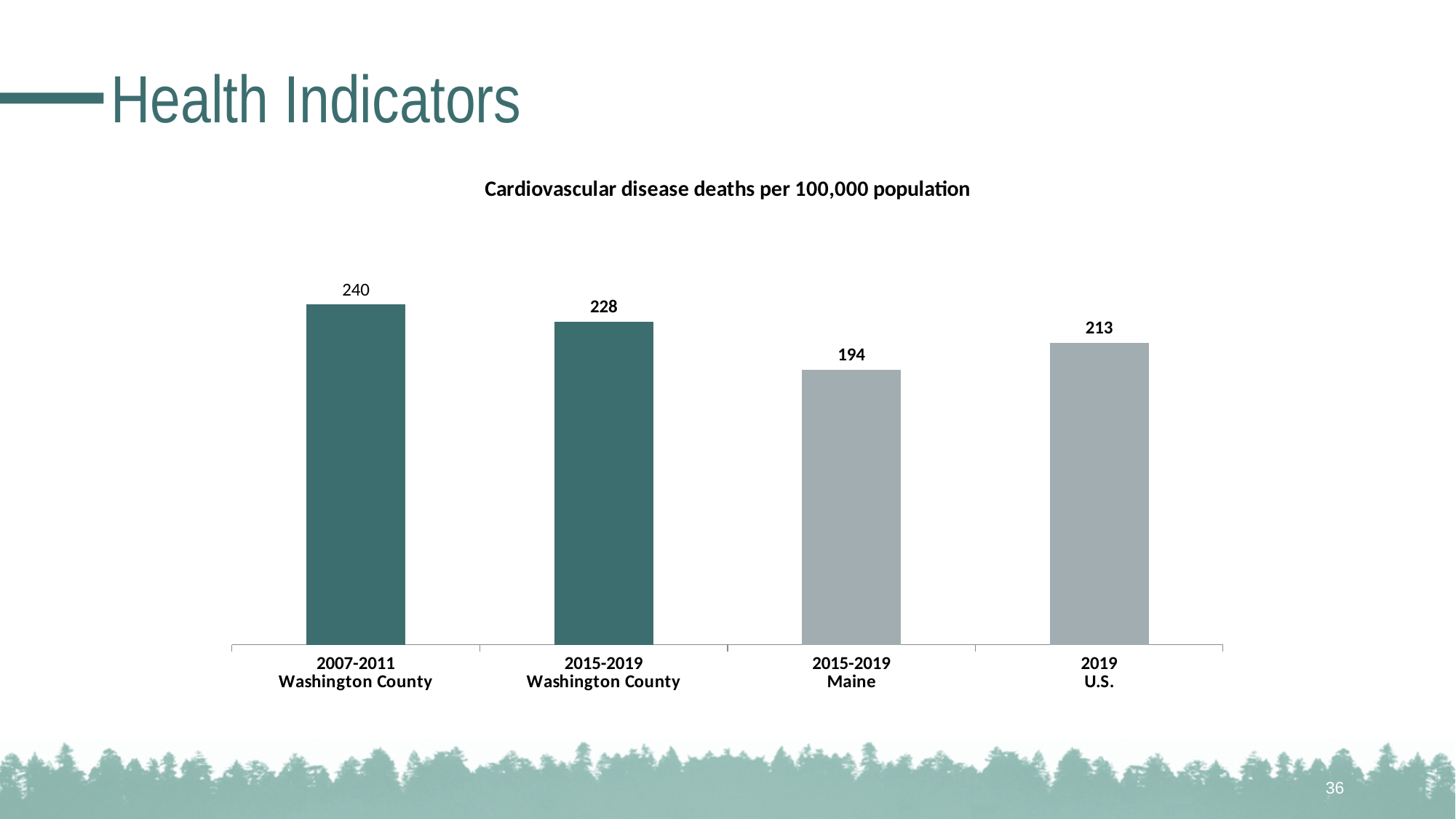
What is the value for 2019 U.S.? 213 Which category has the highest value? 2007-2011 Washington County What is the value for 2015-2019 Washington County? 228 What kind of chart is shown on the slide? Bar chart Which category has the lowest value? 2015-2019 Maine What is the difference between the 2019 U.S. value and the 2015-2019 Maine value? 19 How many bars are shown in the chart? 4 What is the title of the chart? Cardiovascular disease deaths per 100,000 population Which is larger, the value for 2015-2019 Washington County or the value for 2019 U.S.? 2015-2019 Washington County What is the difference between the 2007-2011 Washington County value and the 2015-2019 Washington County value? 12 What is the value for 2007-2011 Washington County? 240 What is the value for 2015-2019 Maine? 194